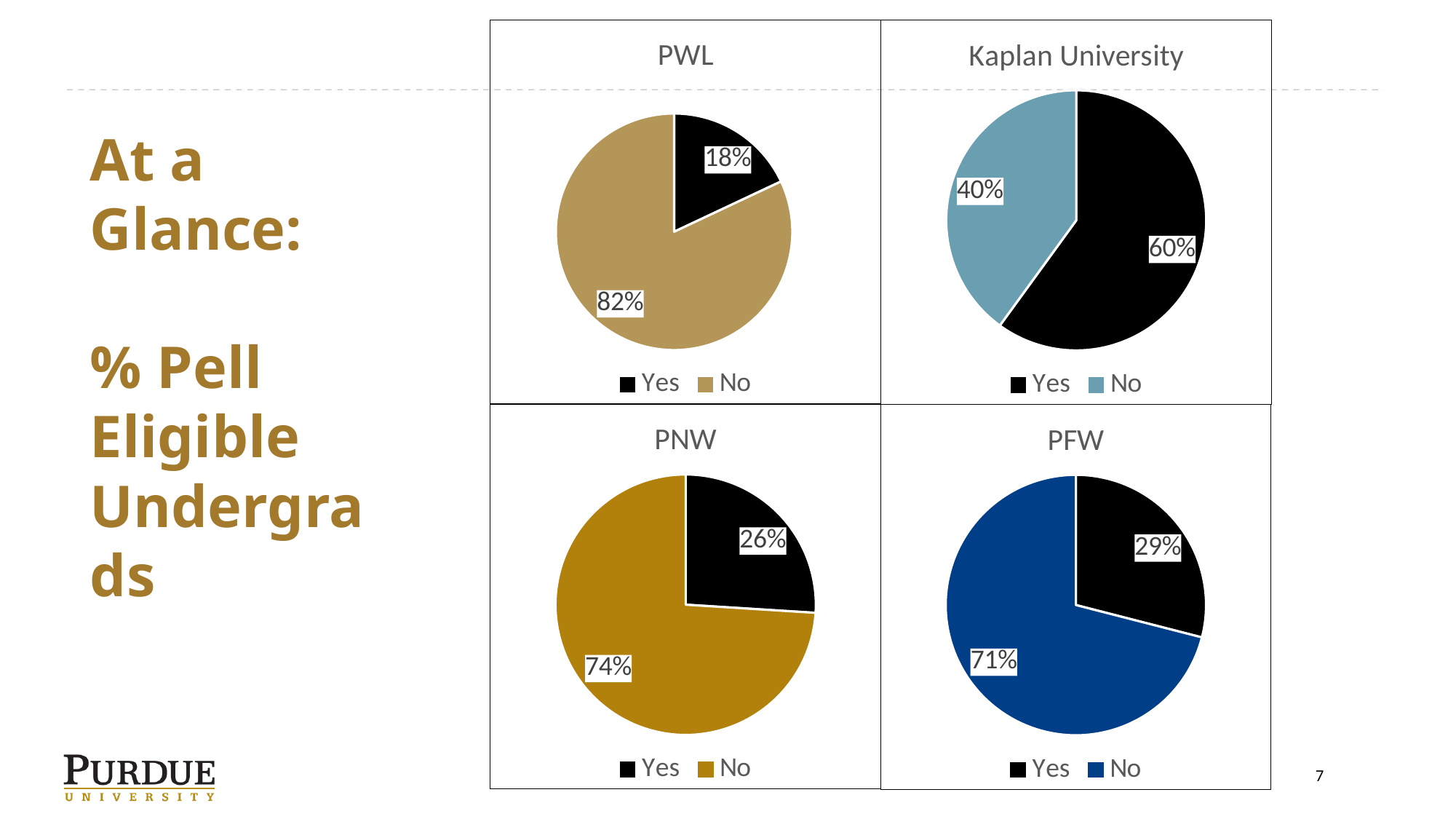
In the PFW chart, which slice is larger, Yes or No? No In the PNW chart, what is the difference between the No and Yes percentages? 48% In the Kaplan University chart, what percentage is shown for the No slice? 40% In the PWL chart, what percentage is shown for the Yes slice? 18% What kind of chart is the PWL chart? Pie chart In the PFW chart, what percentage is shown for the No slice? 71% In the Kaplan University chart, which slice is larger, Yes or No? Yes How many pie charts are shown on the slide? 4 How many entries does the legend of the PFW chart list? 2 In the Kaplan University chart, what percentage is shown for the Yes slice? 60% In the PWL chart, what percentage is shown for the No slice? 82% In the PNW chart, what percentage is shown for the Yes slice? 26%